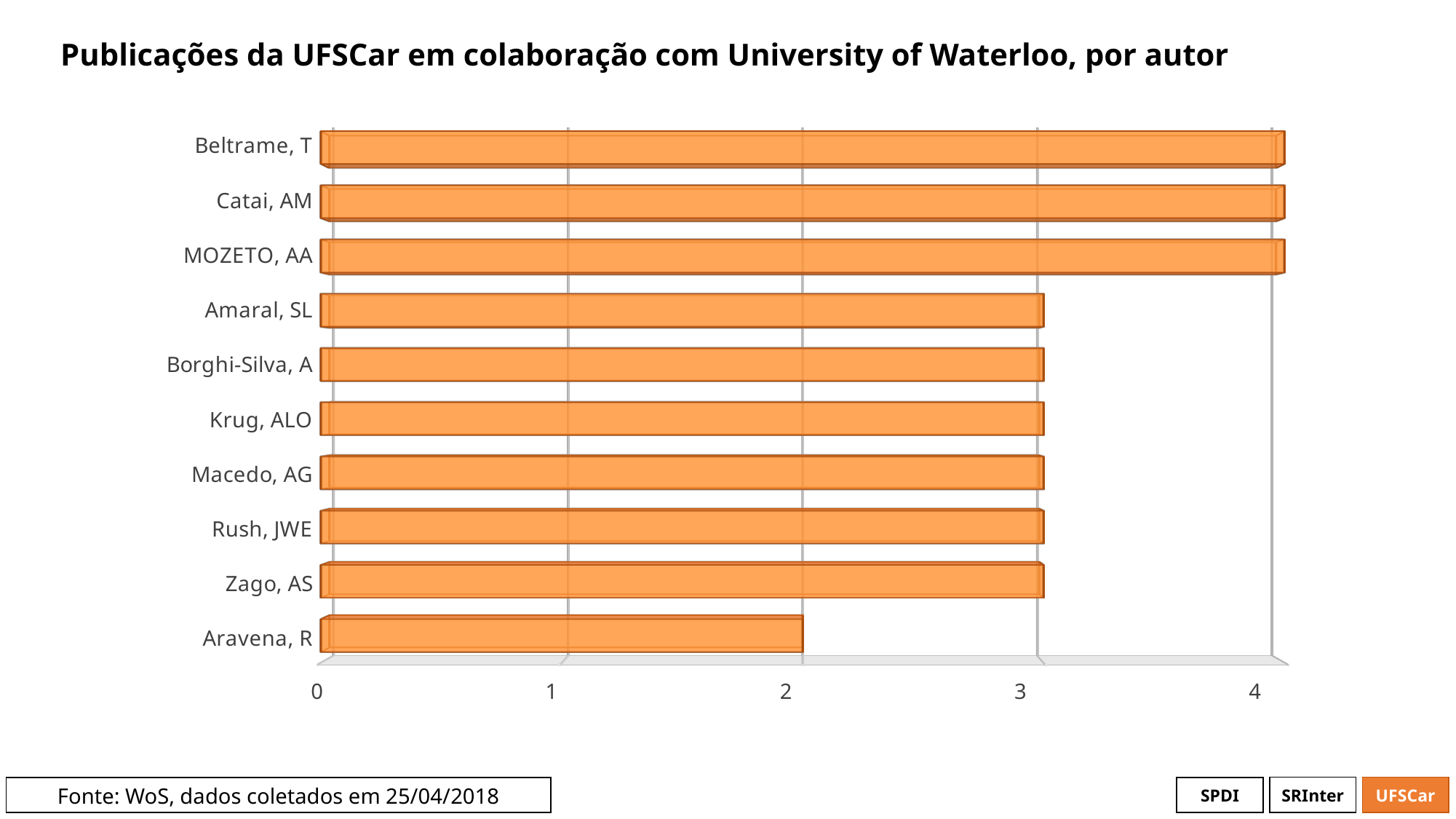
What is the difference in publications between Beltrame, T and Aravena, R? 2 What kind of chart is shown on the slide? bar chart What is the data source cited on the slide? WoS, dados coletados em 25/04/2018 Is the value for Catai, AM greater or less than 3? greater Who has more publications, MOZETO, AA or Krug, ALO? MOZETO, AA What is the title of the chart? Publicações da UFSCar em colaboração com University of Waterloo, por autor Which author has the lowest number of publications? Aravena, R Is the value for Aravena, R greater or less than 3? less How many authors are listed in the chart? 10 How many publications does Beltrame, T have? 4 How many publications does Aravena, R have? 2 How many publications does Zago, AS have? 3